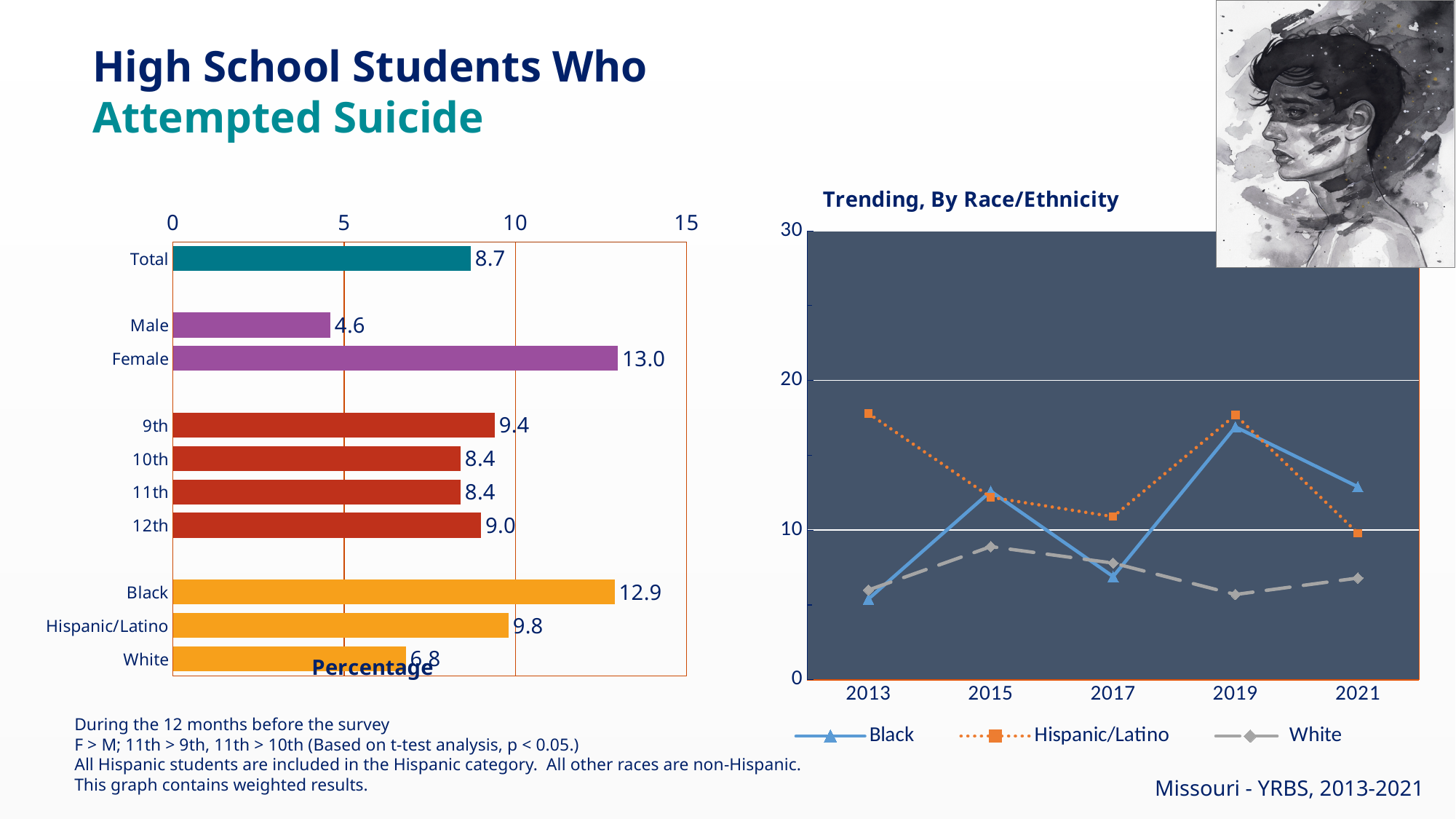
In the 'Trending, By Race/Ethnicity' chart, is the value for White in 2015 greater or less than 10? less In the left bar chart, which is larger, the value for 9th or the value for 12th? 9th In the 'Trending, By Race/Ethnicity' chart, how many series does the legend list? 3 What kind of chart is the left chart? bar chart In the left bar chart, what is the difference between the Black and White values? 6.1 In the left bar chart, what is the value for Hispanic/Latino? 9.8 In the 'Trending, By Race/Ethnicity' chart, is the value for Hispanic/Latino in 2013 greater or less than 10? greater In the left bar chart, what is the value for Female? 13.0 In the 'Trending, By Race/Ethnicity' chart, how many years are shown on the x axis? 5 In the left bar chart, what is the difference between the Female and Male values? 8.4 In the left bar chart, which category has the lowest value? Male In the left bar chart, which category has the highest value? Female